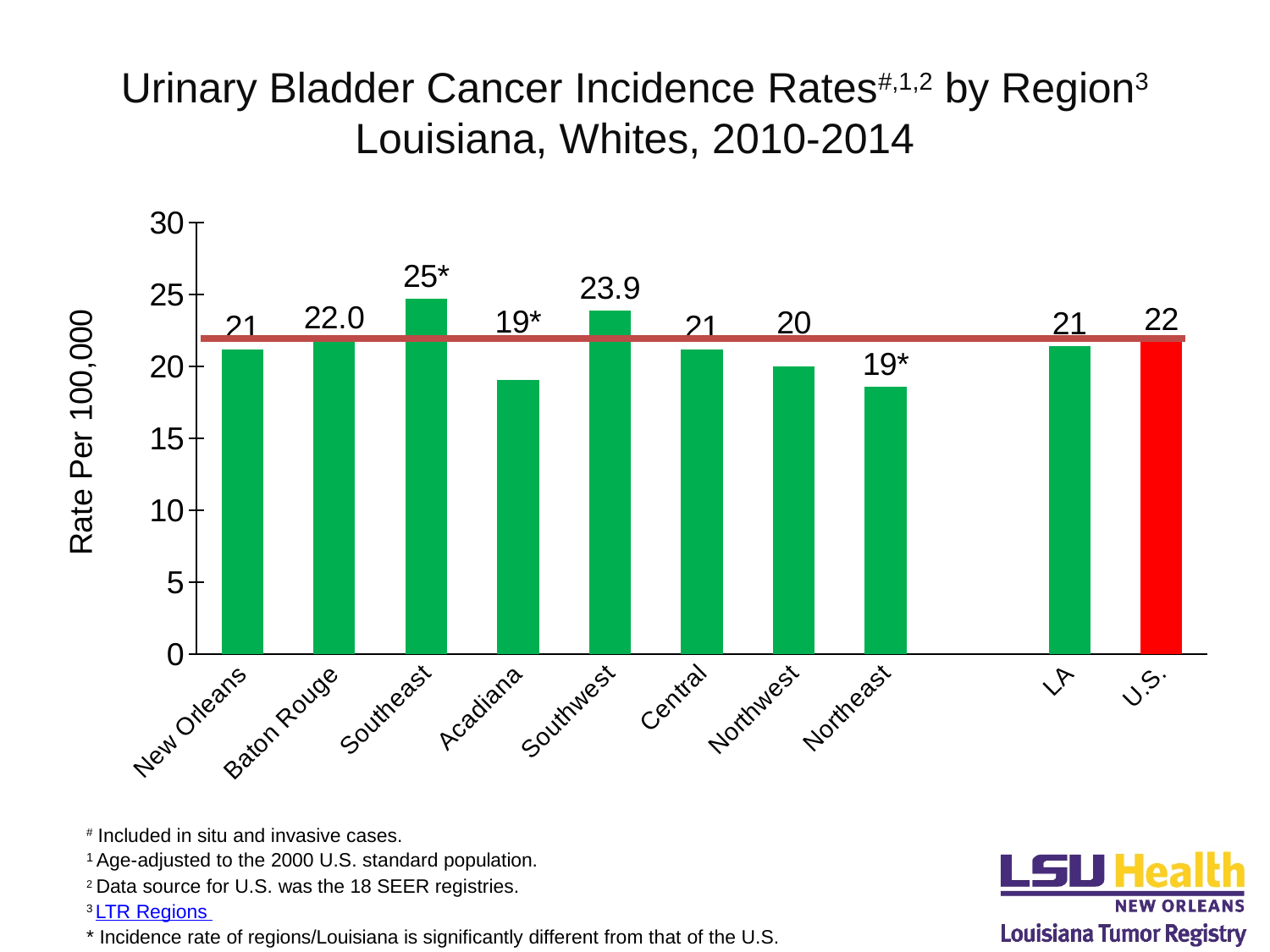
What kind of chart is shown on the slide? bar chart What is the difference between the Southeast value (25) and the Northwest value (20)? 5 How many bars are plotted in the chart? 10 Is the value for Acadiana greater or less than 20? less Which region has the highest incidence rate? Southeast What is the value labeled for the U.S. bar? 22 What is the value labeled for Baton Rouge? 22.0 Which has a higher incidence rate, Southwest or Central? Southwest What is the difference between the Southwest value and the Baton Rouge value? 1.9 What is the label on the vertical axis of the chart? Rate Per 100,000 What is the urinary bladder cancer incidence rate shown for Southwest? 23.9 What is the value labeled for Northwest? 20